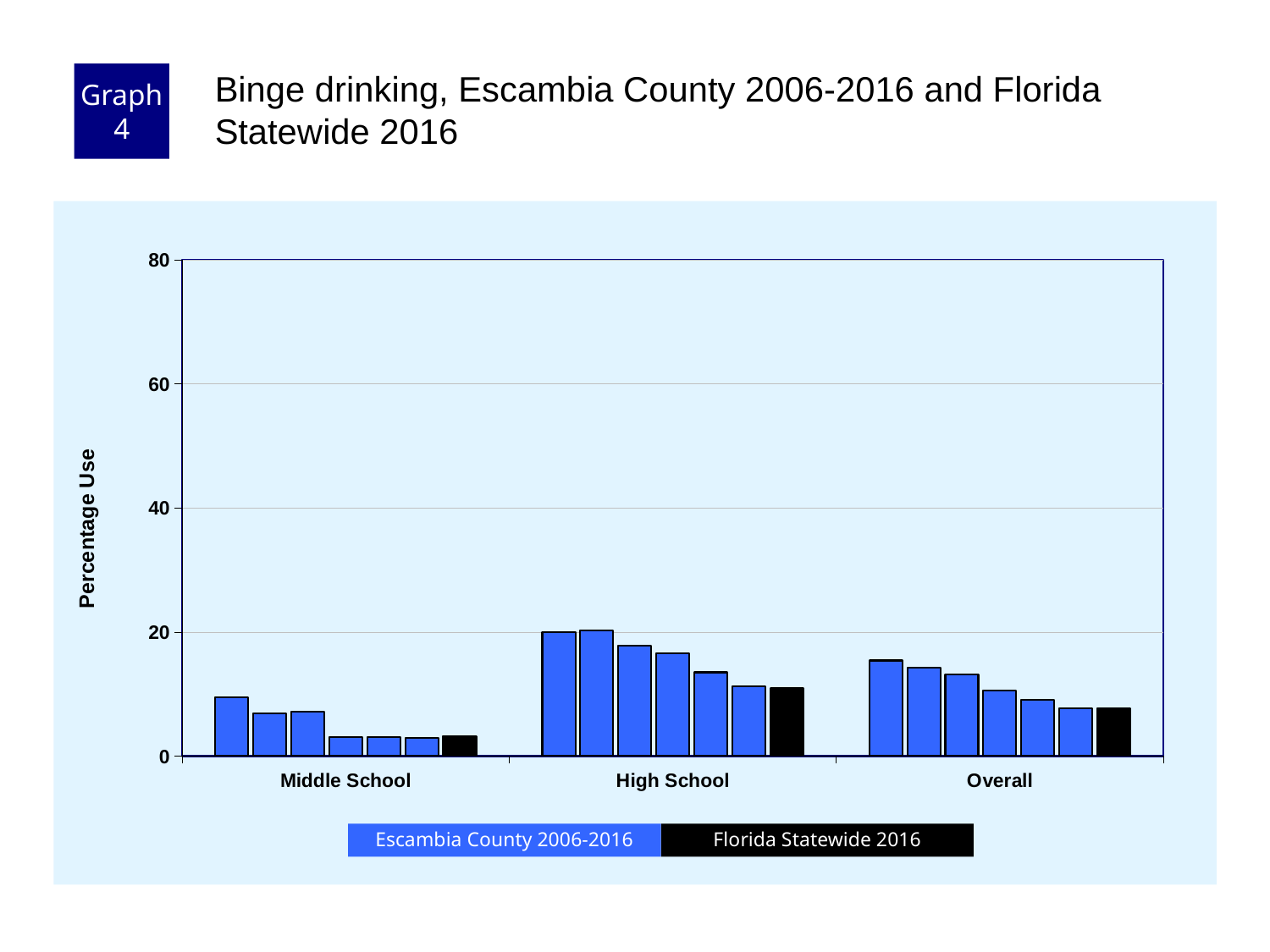
Is the Florida Statewide 2016 value for High School greater or less than 20? less Is the Florida Statewide 2016 value for Middle School greater or less than 20? less What colour are the Florida Statewide 2016 bars? black What is the label on the y axis? Percentage Use How many series does the legend list? 2 What kind of chart is shown on the slide? bar chart Is the tallest bar for Overall greater or less than 20? less Which category has the lowest bars overall? Middle School How many categories are shown on the x axis? 3 Which category has the highest bars overall? High School Do the Escambia County 2006-2016 bars for High School rise or fall from left to right? fall Is the Florida Statewide 2016 bar for High School taller or shorter than the Florida Statewide 2016 bar for Middle School? taller